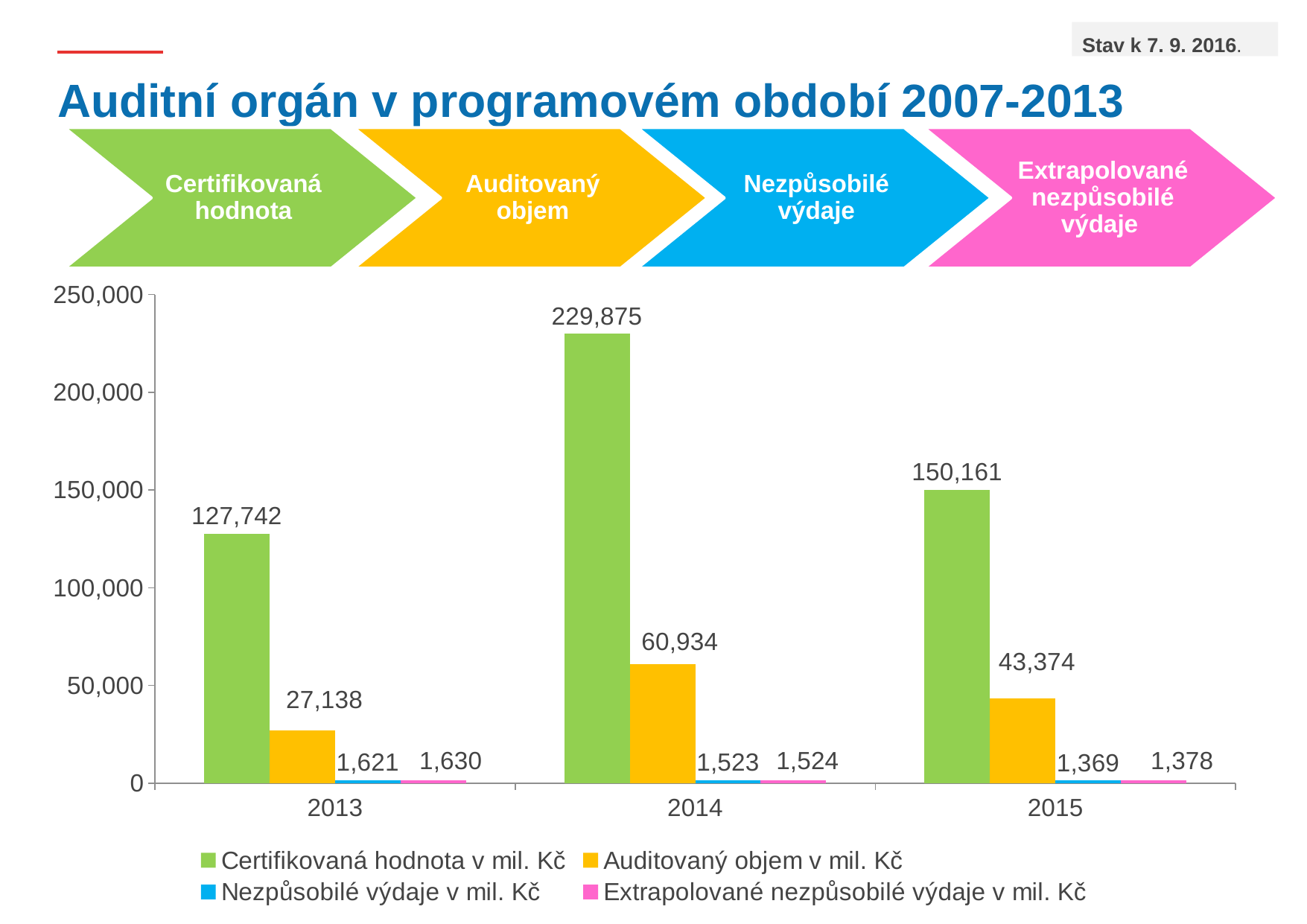
What kind of chart is shown on the slide? bar chart What is the value of Certifikovaná hodnota v mil. Kč for 2014? 229,875 What is the difference between Certifikovaná hodnota v mil. Kč in 2014 and in 2013? 102,133 In which year is Auditovaný objem v mil. Kč the lowest? 2013 In which year is Certifikovaná hodnota v mil. Kč the highest? 2014 How many series does the legend list? 4 What is the value of Auditovaný objem v mil. Kč for 2015? 43,374 Does Nezpůsobilé výdaje v mil. Kč rise or fall from 2013 to 2015? fall What is the value of Nezpůsobilé výdaje v mil. Kč for 2013? 1,621 What is the value of Extrapolované nezpůsobilé výdaje v mil. Kč for 2015? 1,378 Which is larger: Certifikovaná hodnota v mil. Kč in 2015 or in 2013? 2015 What is the difference between Auditovaný objem v mil. Kč in 2014 and in 2015? 17,560